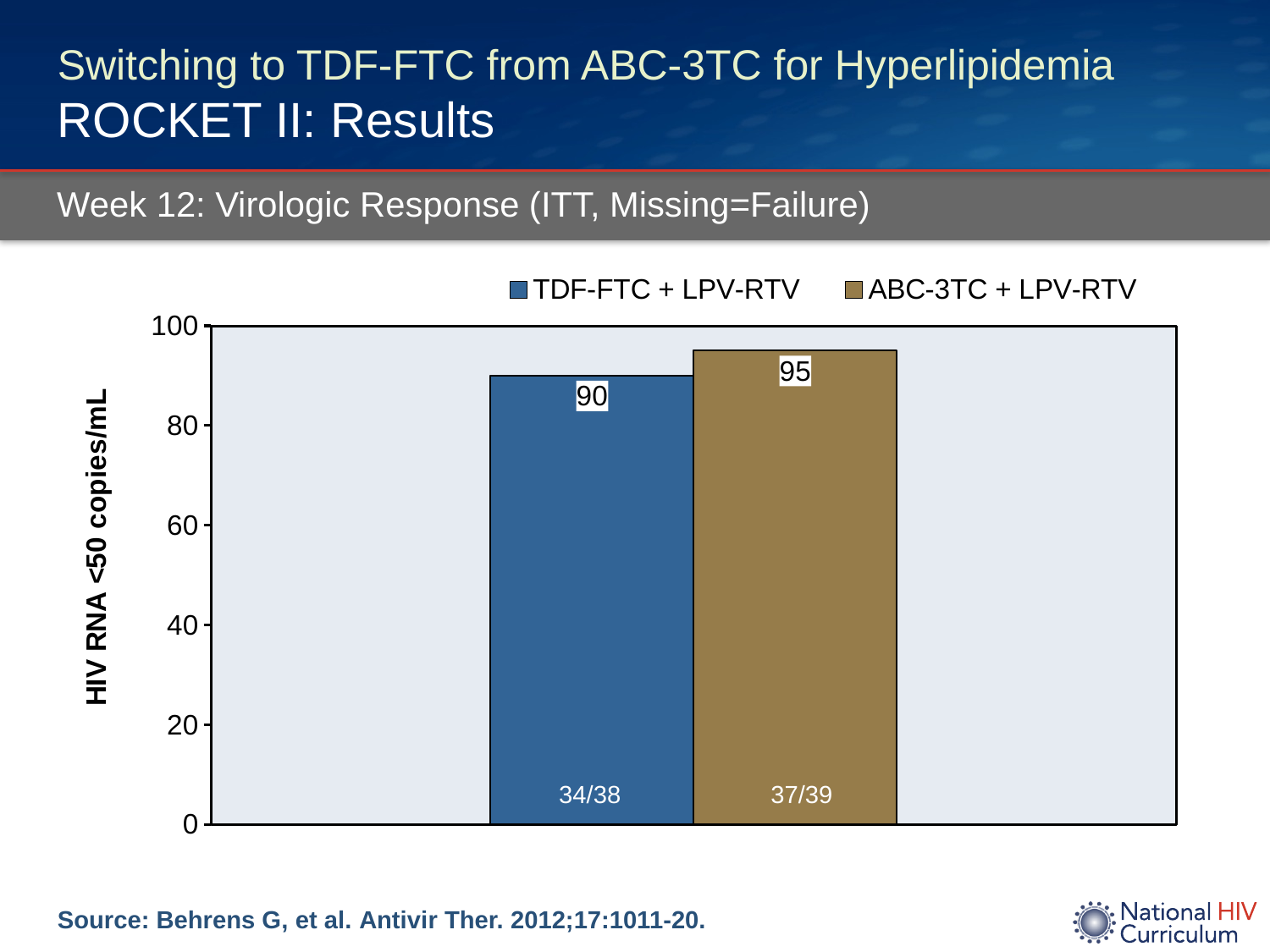
What is the label of the y axis? HIV RNA <50 copies/mL What is the value for ABC-3TC + LPV-RTV? 95 Which series has the lowest value? TDF-FTC + LPV-RTV Which is larger, the value for TDF-FTC + LPV-RTV or the value for ABC-3TC + LPV-RTV? ABC-3TC + LPV-RTV What is the value for TDF-FTC + LPV-RTV? 90 What kind of chart is shown on the slide? bar chart What is the difference between the values for ABC-3TC + LPV-RTV and TDF-FTC + LPV-RTV? 5 What fraction is printed inside the ABC-3TC + LPV-RTV bar? 37/39 What fraction is printed inside the TDF-FTC + LPV-RTV bar? 34/38 Is the value for TDF-FTC + LPV-RTV greater or less than 80? greater Which series has the highest value? ABC-3TC + LPV-RTV How many series does the legend list? 2